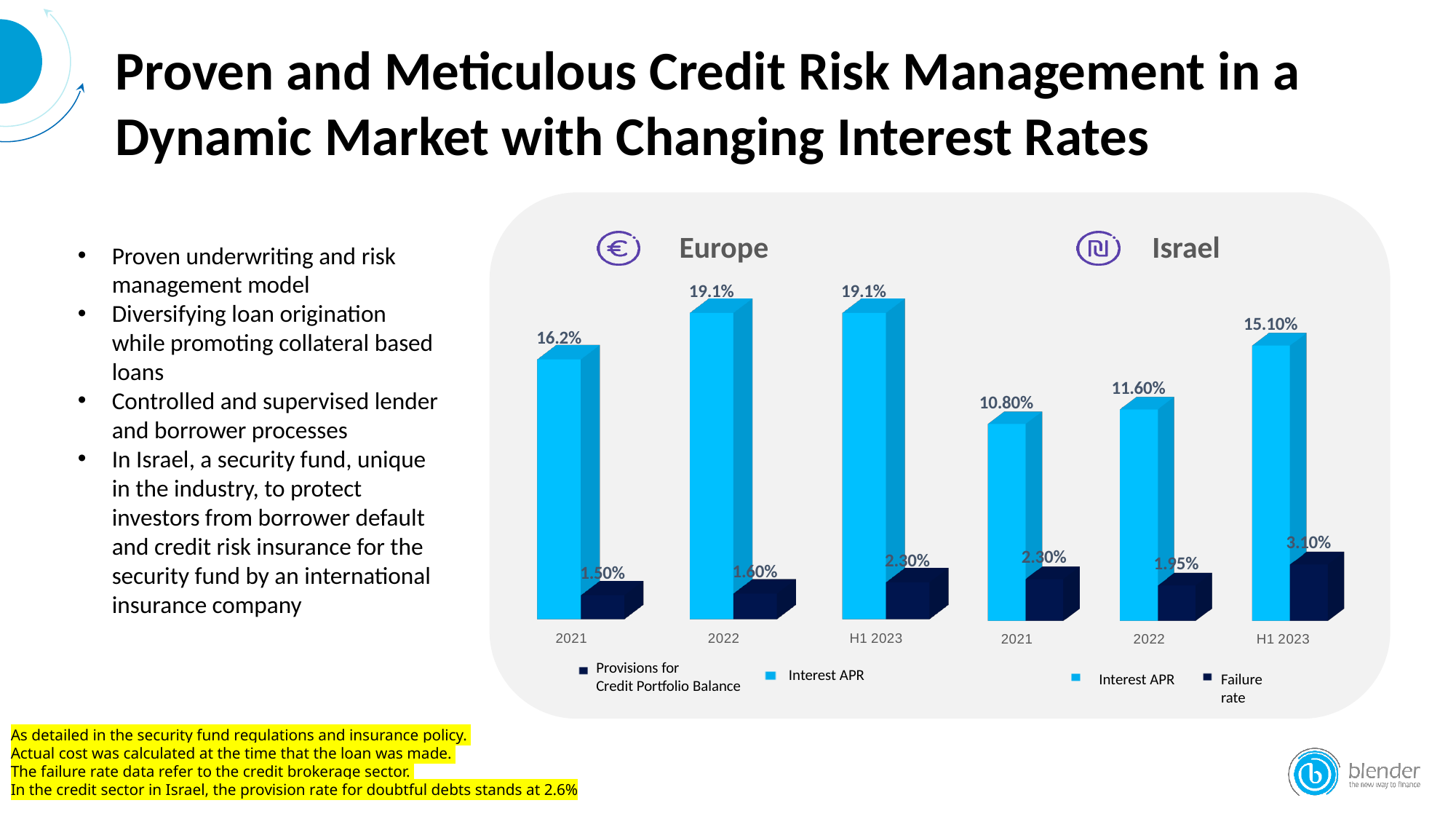
Which is larger: the Interest APR for 2021 in the Europe chart or the Interest APR for 2021 in the Israel chart? Europe In the Europe chart, what is the Interest APR for 2021? 16.2% In the Europe chart, what is the Provisions for Credit Portfolio Balance value for H1 2023? 2.30% How many periods are shown on the x axis of the Israel chart? 3 What type of chart is used for the Israel data? Bar chart In the Israel chart, what is the difference between the Failure rate in H1 2023 and in 2021? 0.80% In the Europe chart, what is the difference between the Interest APR in 2022 and in 2021? 2.9% How many series does the legend of the Europe chart list? 2 In the Israel chart, what is the Failure rate for 2022? 1.95% In the Israel chart, which period has the lowest Failure rate? 2022 In the Israel chart, what is the Interest APR for H1 2023? 15.10% In the Israel chart, which period has the highest Interest APR? H1 2023